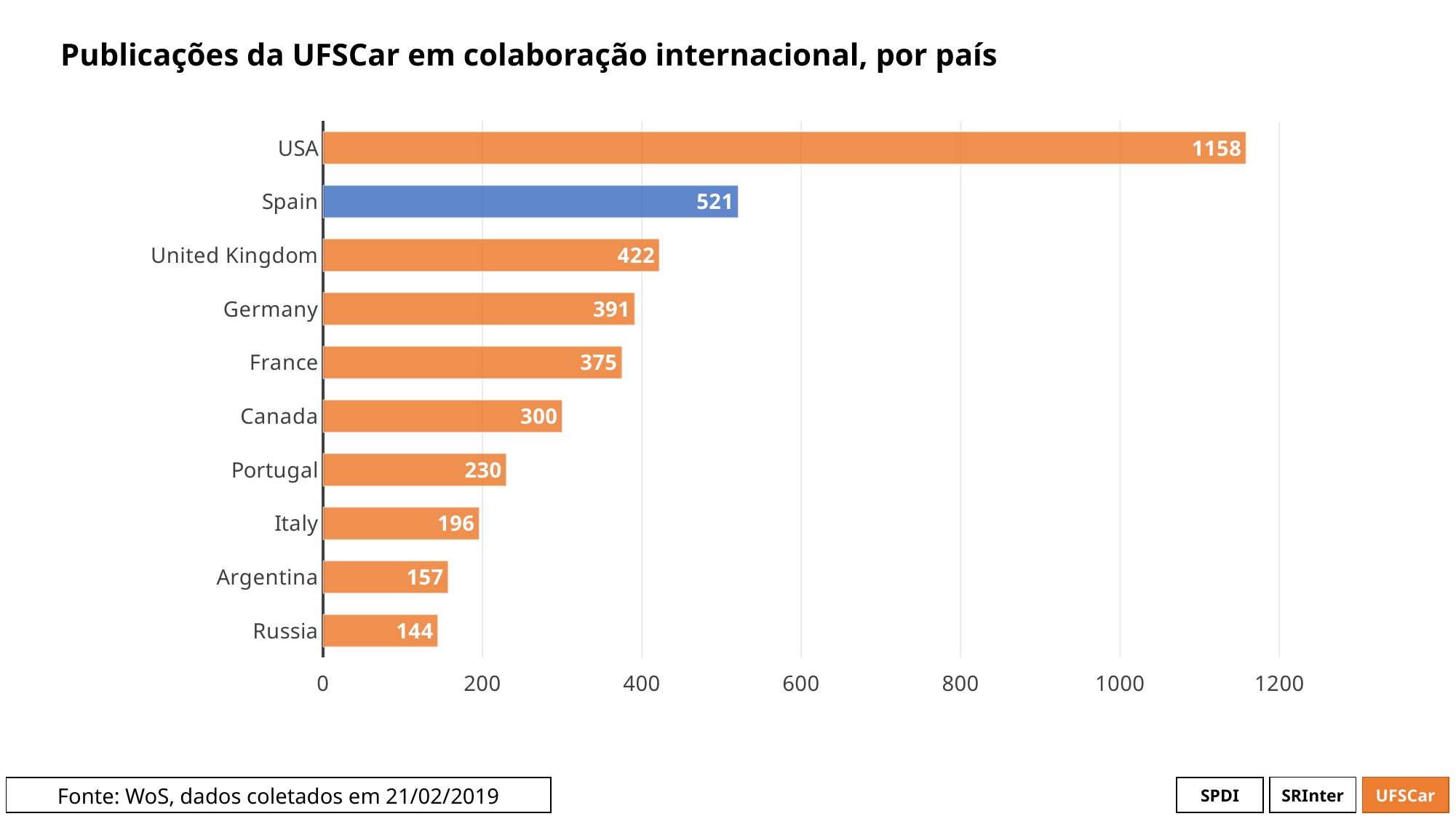
What is the difference between the values for USA and Spain? 637 Which is larger, the value for France or the value for Canada? France Is the value for United Kingdom greater or less than 400? greater Which country has the lowest value? Russia What is the value for Portugal? 230 What kind of chart is shown on the slide? bar chart What is the value for Germany? 391 How many countries are shown in the chart? 10 Which country's bar is coloured blue instead of orange? Spain What is the difference between the values for Italy and Argentina? 39 Which country has the highest value? USA What is the value for Spain? 521